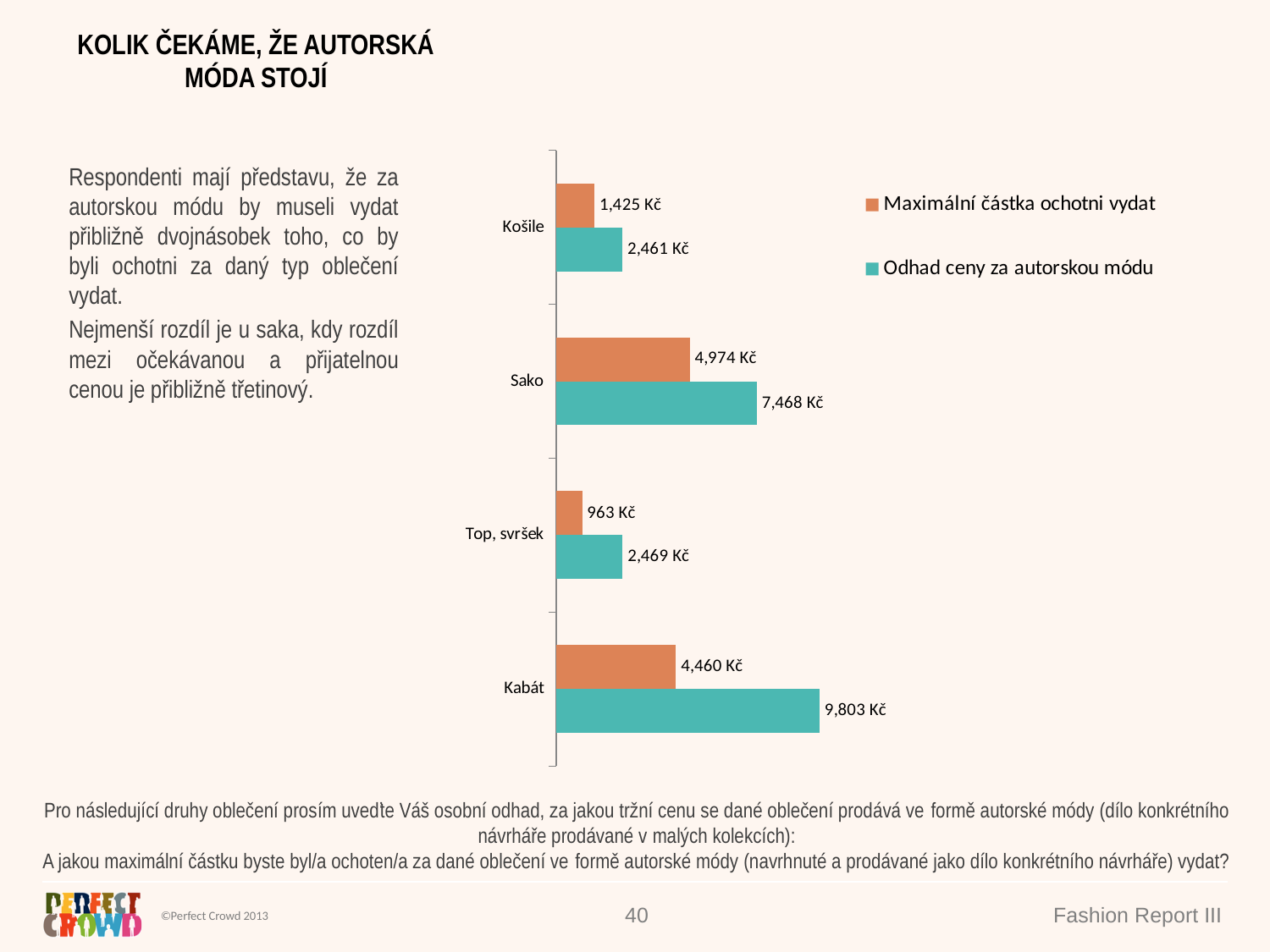
Which category has the highest value for "Odhad ceny za autorskou módu"? Kabát What is the difference between "Odhad ceny za autorskou módu" and "Maximální částka ochotni vydat" for Sako? 2,494 Kč Which colour represents "Odhad ceny za autorskou módu" in the chart? Teal What is the value of "Maximální částka ochotni vydat" for Sako? 4,974 Kč What is the value of "Odhad ceny za autorskou módu" for Košile? 2,461 Kč Which category has the lowest value for "Maximální částka ochotni vydat"? Top, svršek What type of chart is shown on the slide? Bar chart What is the value of "Maximální částka ochotni vydat" for Top, svršek? 963 Kč How many series does the legend list? 2 How many clothing categories are shown in the chart? 4 Which is larger for Kabát: "Maximální částka ochotni vydat" or "Odhad ceny za autorskou módu"? Odhad ceny za autorskou módu What is the value of "Odhad ceny za autorskou módu" for Kabát? 9,803 Kč